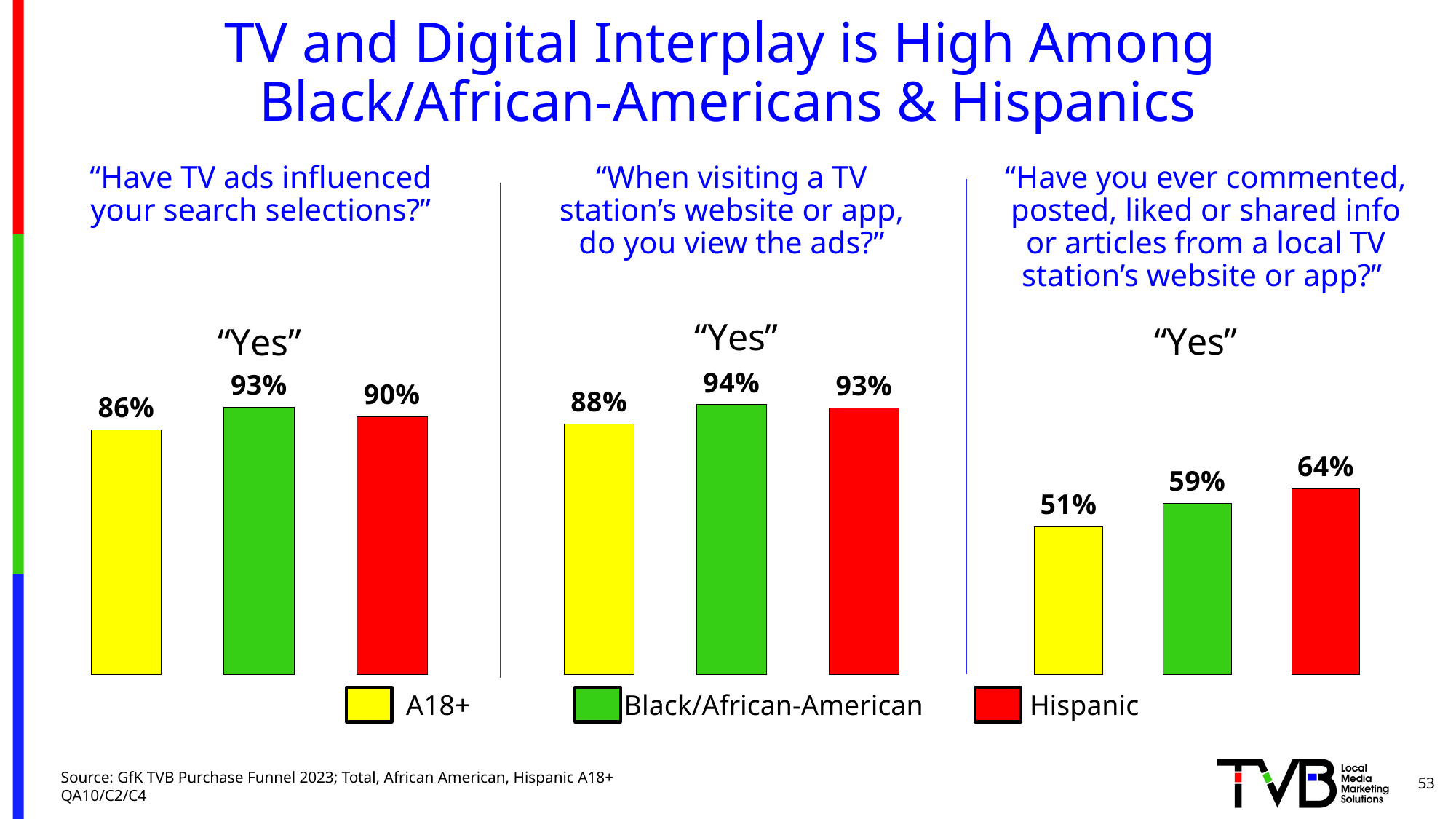
What type of chart is used on this slide? Bar chart In the right chart ("Have you ever commented, posted, liked or shared info or articles from a local TV station's website or app?"), what is the value for Hispanic? 64% In the middle chart ("When visiting a TV station's website or app, do you view the ads?"), what is the difference between the Black/African-American value and the A18+ value? 6% In the left chart ("Have TV ads influenced your search selections?"), which is larger: the Hispanic value or the A18+ value? Hispanic In the left chart ("Have TV ads influenced your search selections?"), what percentage of A18+ answered "Yes"? 86% In the right chart ("Have you ever commented, posted, liked or shared info..."), which group has the lowest value? A18+ In the right chart ("Have you ever commented, posted, liked or shared info..."), what is the difference between the Hispanic value and the A18+ value? 13% How many bars are shown in the middle chart ("When visiting a TV station's website or app, do you view the ads?")? 3 How many series does the legend at the bottom of the slide list? 3 Which colour represents Hispanic in the legend? Red In the middle chart ("When visiting a TV station's website or app, do you view the ads?"), what is the value for Black/African-American? 94% In the left chart ("Have TV ads influenced your search selections?"), which group has the highest "Yes" percentage? Black/African-American